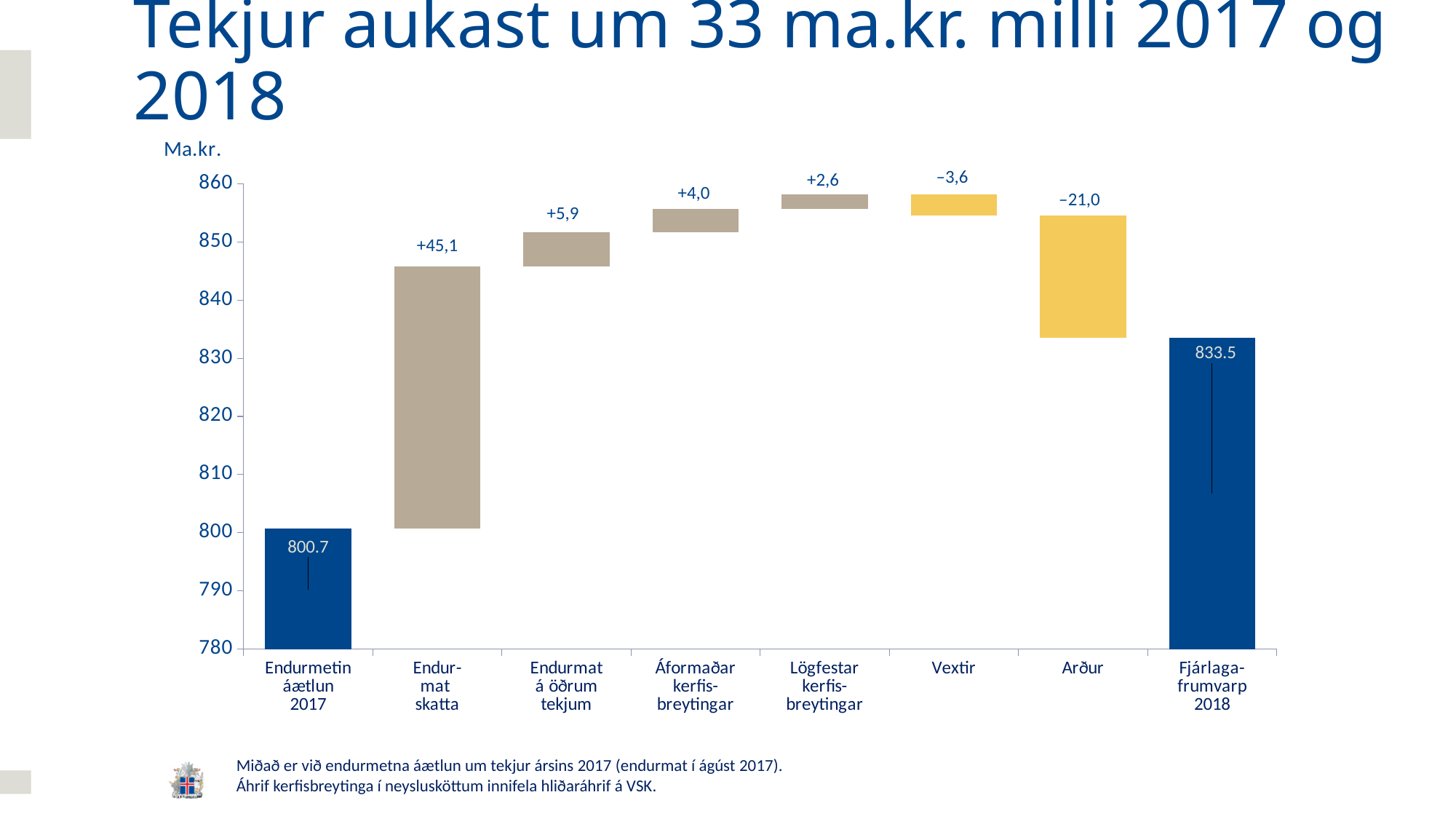
What change is labelled on the Endurmat skatta bar? +45,1 What kind of chart is shown on the slide? bar chart Which category shows the largest negative change? Arður What change is labelled on the Vextir bar? –3,6 Which category shows the largest positive change? Endurmat skatta How many categories are shown on the x axis? 8 Which change is larger: Endurmat á öðrum tekjum or Áformaðar kerfisbreytingar? Endurmat á öðrum tekjum What unit is written above the y axis? Ma.kr. What change is labelled on the Arður bar? –21,0 What is the value shown for Fjárlagafrumvarp 2018? 833.5 What is the difference between the Fjárlagafrumvarp 2018 value and the Endurmetin áætlun 2017 value? 32.8 What is the value shown for Endurmetin áætlun 2017? 800.7